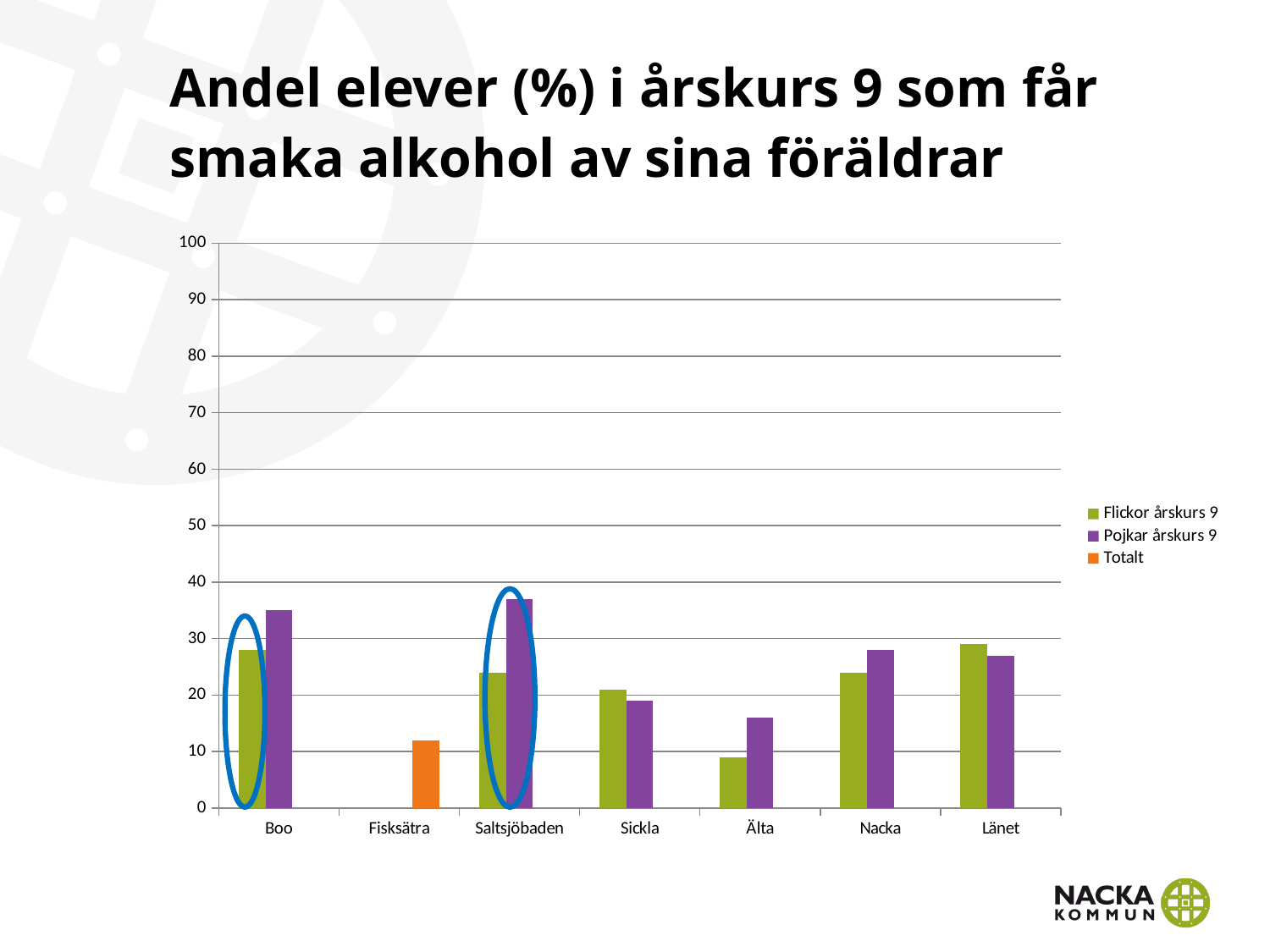
Is the value for Pojkar årskurs 9 in Boo greater or less than 30? greater How many series does the legend list? 3 How many categories are shown on the x axis? 7 In Älta, which is larger: Flickor årskurs 9 or Pojkar årskurs 9? Pojkar årskurs 9 In Boo, which is larger: Flickor årskurs 9 or Pojkar årskurs 9? Pojkar årskurs 9 Which category has the lowest value for Flickor årskurs 9? Älta What kind of chart is shown on the slide? bar chart Is the value for Pojkar årskurs 9 in Nacka greater or less than 30? less Is the value for Flickor årskurs 9 in Älta greater or less than 10? less Which category has the lowest value for Pojkar årskurs 9? Älta Which category is the only one with a Totalt (orange) bar? Fisksätra